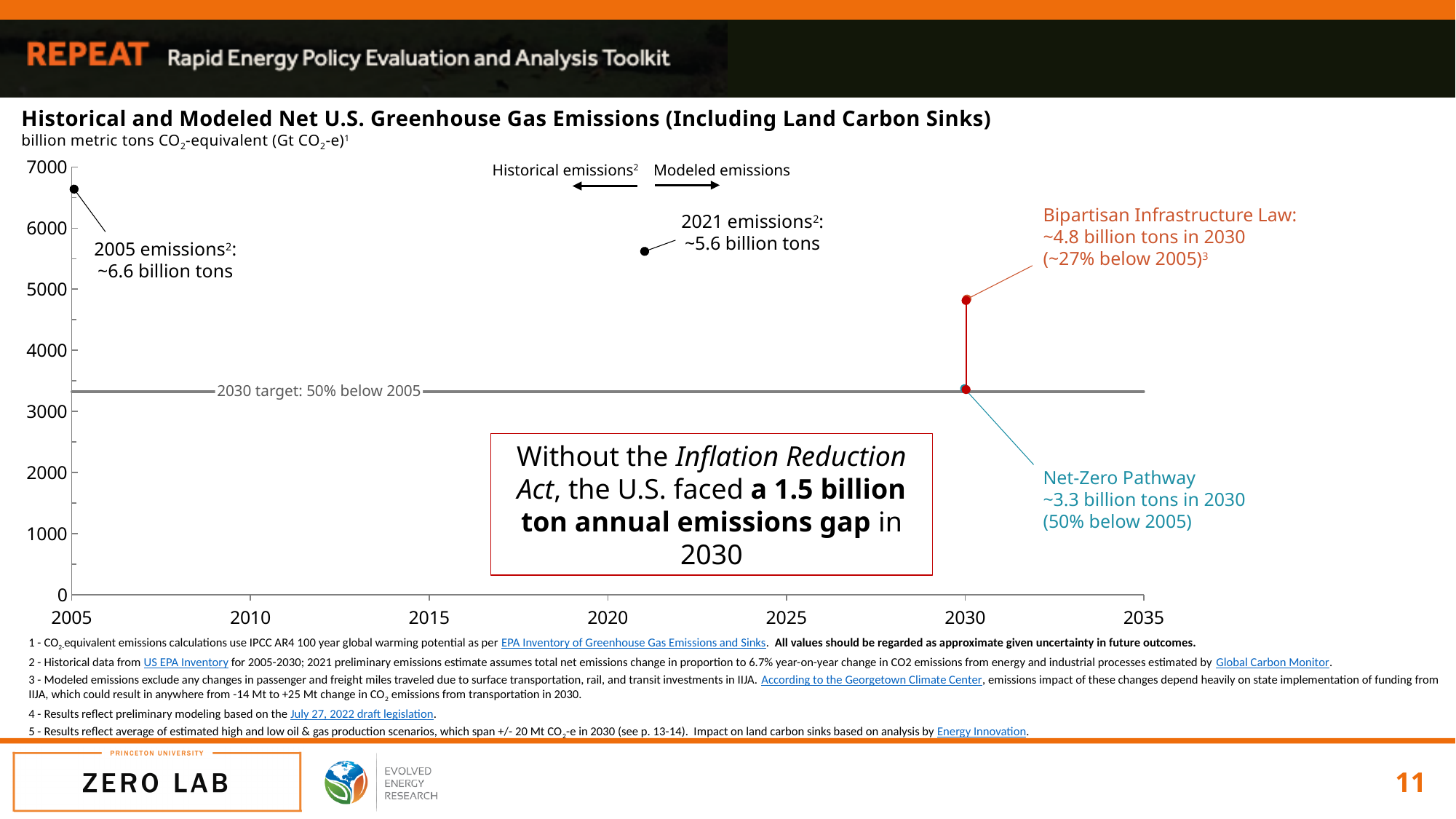
Do historical emissions rise or fall from 2005 to 2021? fall Is the 2030 value for the Bipartisan Infrastructure Law greater or less than 5000? less Is the value plotted for 2021 emissions greater or less than 5000? greater Which is larger in 2030: the Bipartisan Infrastructure Law value or the Net-Zero Pathway value? Bipartisan Infrastructure Law Which plotted point is the highest on the chart? 2005 emissions According to the text box on the chart, how large was the annual emissions gap the U.S. faced in 2030 without the Inflation Reduction Act? 1.5 billion tons Is the 2030 value for the Net-Zero Pathway greater or less than 4000? less How many data points are plotted on the chart? 4 Which plotted point is the lowest on the chart? Net-Zero Pathway (2030) What does the label on the horizontal grey line say the 2030 target is? 50% below 2005